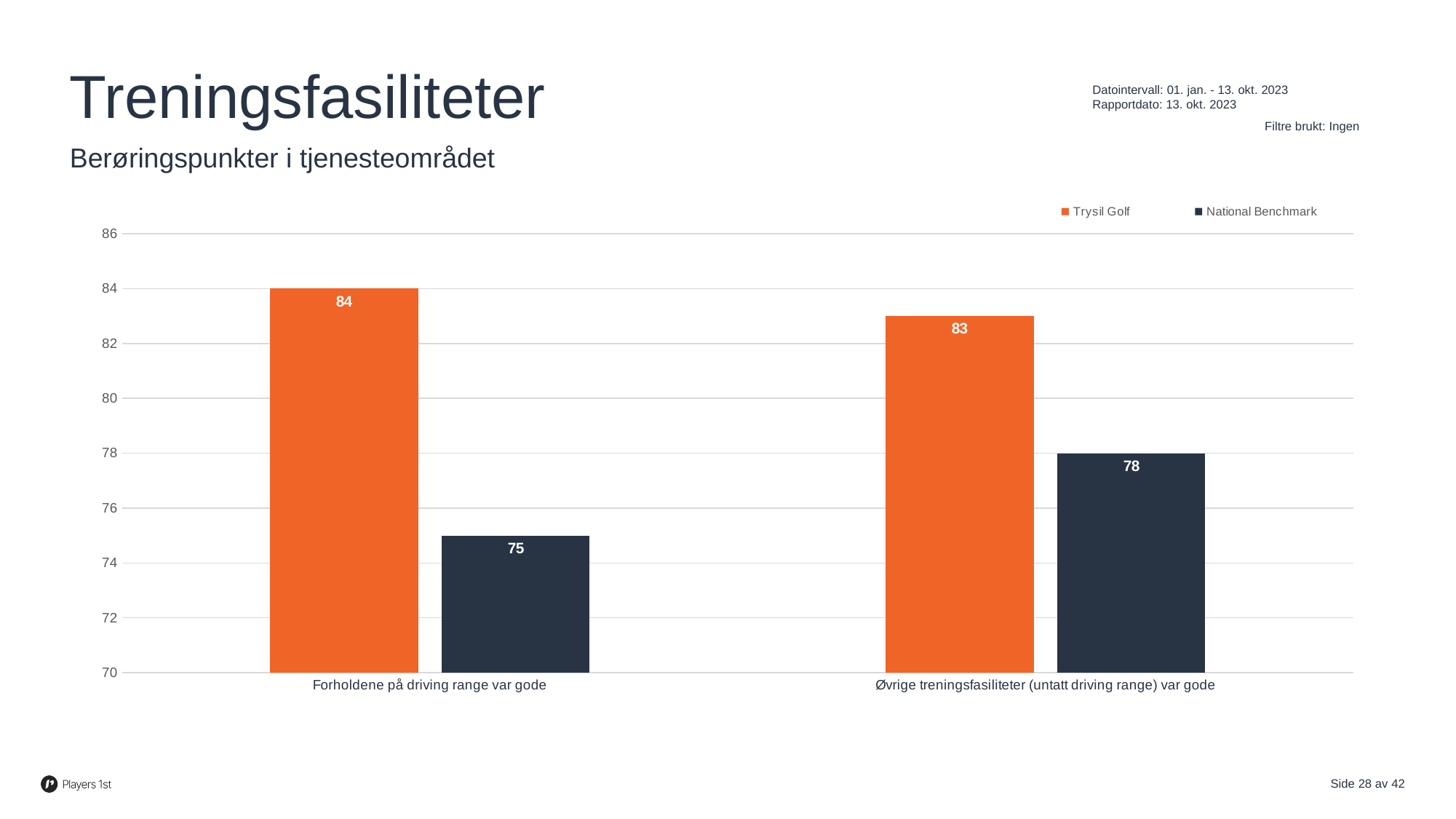
What is the Trysil Golf value for "Øvrige treningsfasiliteter (untatt driving range) var gode"? 83 How many categories are shown on the x axis? 2 Which is larger for "Øvrige treningsfasiliteter (untatt driving range) var gode": Trysil Golf or National Benchmark? Trysil Golf What is the National Benchmark value for "Øvrige treningsfasiliteter (untatt driving range) var gode"? 78 Which category has the lowest National Benchmark value? Forholdene på driving range var gode What is the Trysil Golf value for "Forholdene på driving range var gode"? 84 What kind of chart is shown on the slide? bar chart Is the National Benchmark value for "Forholdene på driving range var gode" greater or less than 80? less How many series does the legend list? 2 What is the difference between the Trysil Golf and National Benchmark values for "Forholdene på driving range var gode"? 9 What is the difference between the Trysil Golf and National Benchmark values for "Øvrige treningsfasiliteter (untatt driving range) var gode"? 5 What is the National Benchmark value for "Forholdene på driving range var gode"? 75